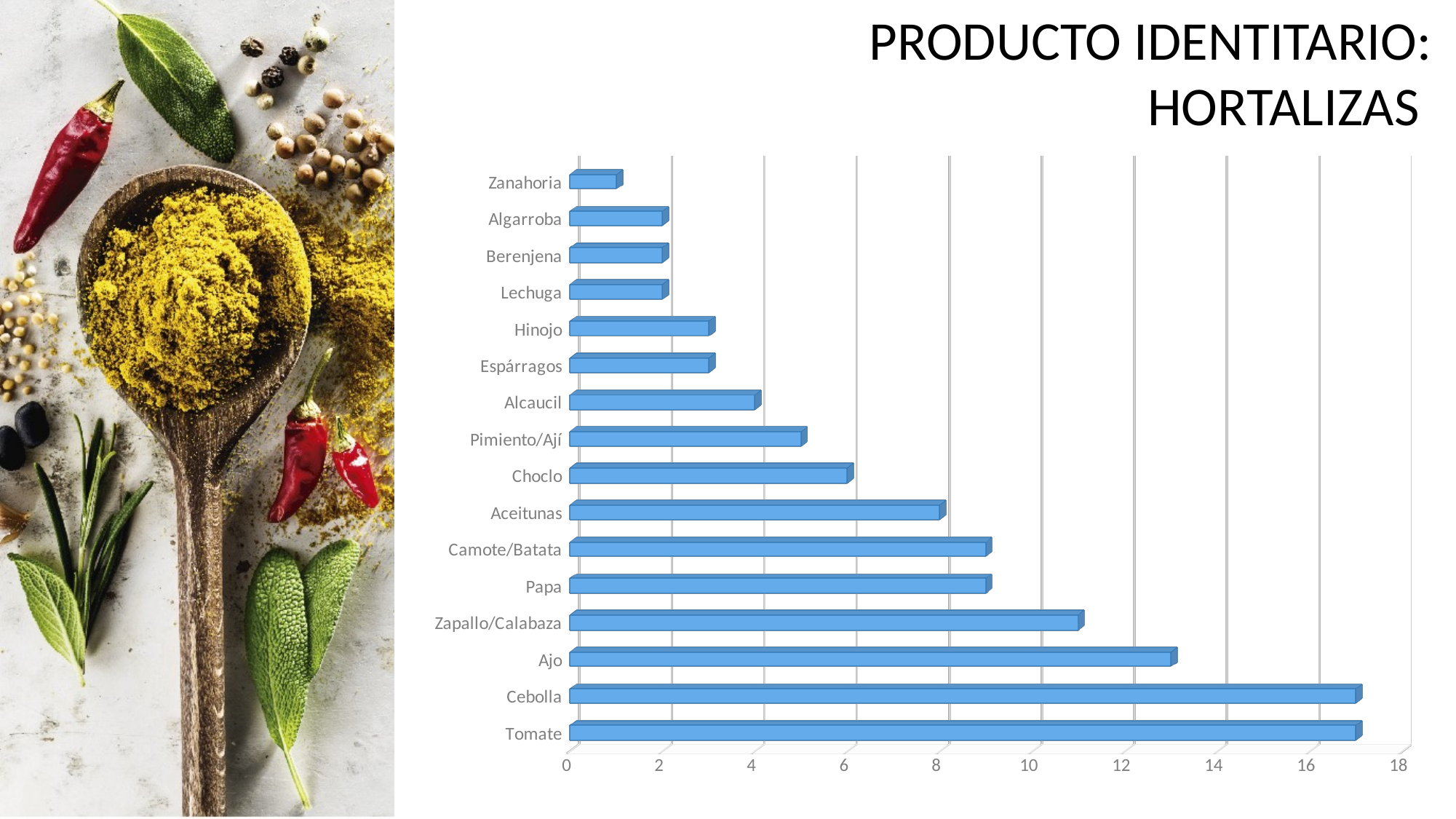
How many categories (hortalizas) are plotted in the chart? 16 Which category has the lowest value in the chart? Zanahoria What colour are the bars in the chart? blue Which has a larger value, Ajo or Zapallo/Calabaza? Ajo Which has a larger value, Aceitunas or Choclo? Aceitunas What is the title shown on the slide above the chart? PRODUCTO IDENTITARIO: HORTALIZAS Is the value for Pimiento/Ají greater or less than 4? greater What kind of chart is shown on the slide? bar chart Is the value for Ajo greater or less than 12? greater Is the value for Zapallo/Calabaza greater or less than 10? greater